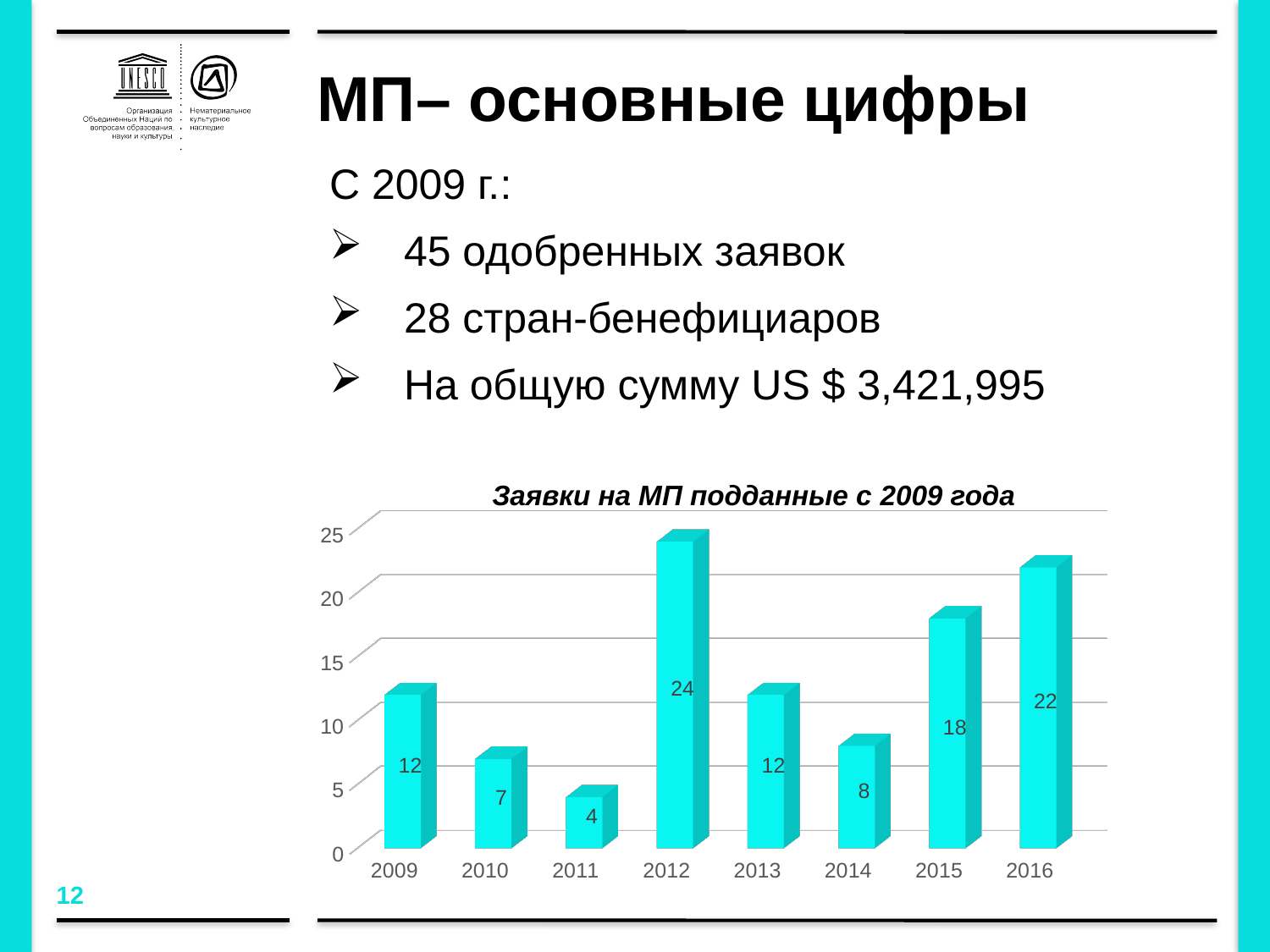
What is the value for 2011 in the chart? 4 What is the title of the chart? Заявки на МП подданные с 2009 года What is the value for 2012 in the chart? 24 Is the value for 2015 greater or less than 15? greater How many years are shown on the x axis of the chart? 8 Which year has the highest value in the chart? 2012 Which is larger, the value for 2010 or the value for 2014? 2014 Which year has the lowest value in the chart? 2011 What kind of chart is shown on the slide? bar chart What is the difference between the values for 2016 and 2014? 14 What is the value for 2015 in the chart? 18 Do the values rise or fall from 2013 to 2014? fall